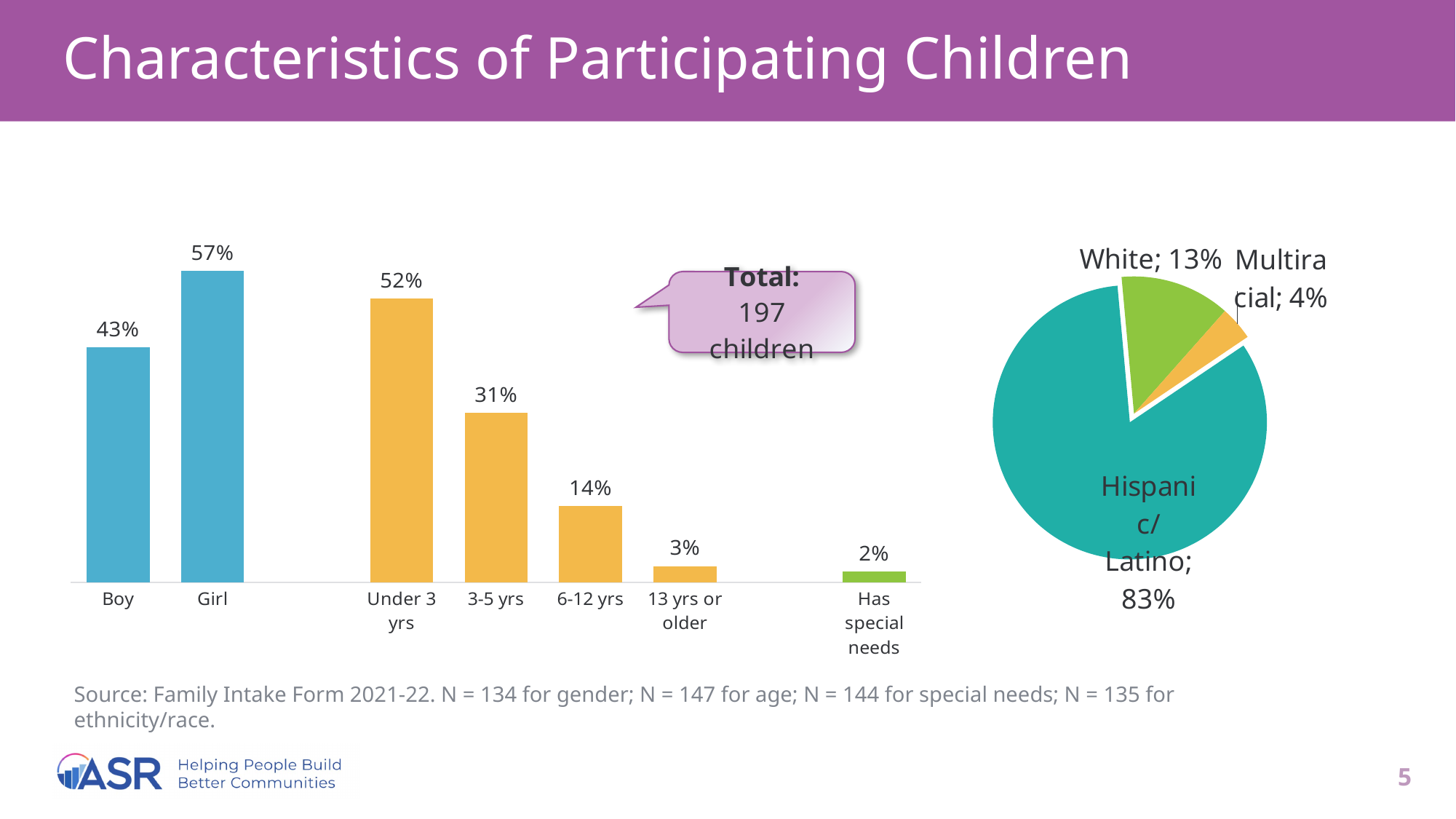
In the bar chart on the left, what is the difference between the Girl and Boy percentages? 14% In the bar chart on the left, what is the value for children under 3 years? 52% In the bar chart on the left, how many bars are plotted in total? 7 In the bar chart on the left, do the values fall or rise across the age groups from Under 3 yrs to 13 yrs or older? fall In the bar chart on the left, which age group has the lowest value? 13 yrs or older In the bar chart on the left, what percentage of participating children are girls? 57% In the pie chart on the right, what share of children are Hispanic/Latino? 83% In the pie chart on the right, which slice is the smallest? Multiracial In the bar chart on the left, what percentage of children have special needs? 2% In the bar chart on the left, which is larger, the value for 3-5 yrs or the value for 6-12 yrs? 3-5 yrs In the bar chart on the left, which age group has the highest value? Under 3 yrs What total number of children is shown in the callout on the slide? 197 children